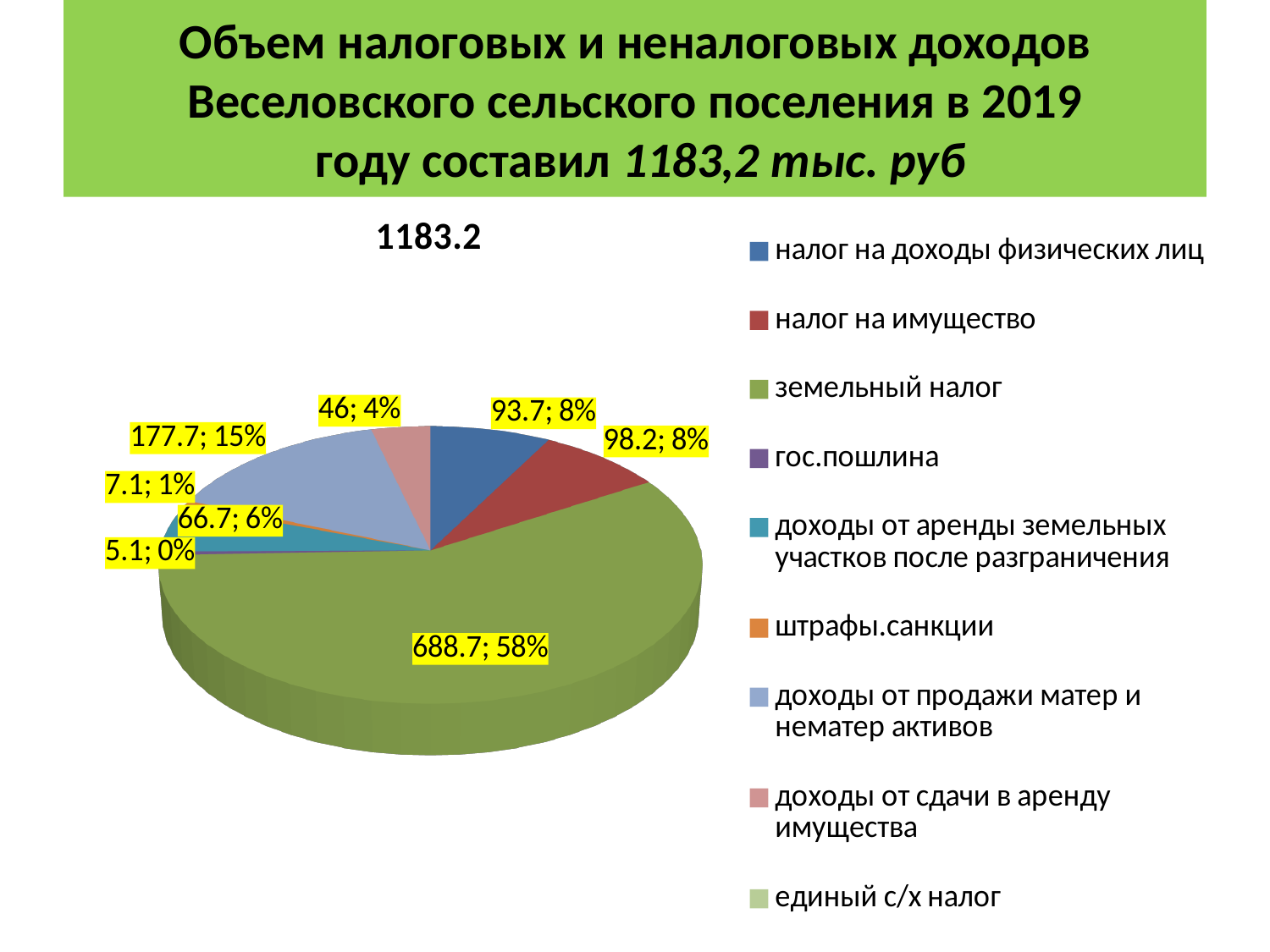
What is the title shown above the pie chart? 1183.2 What is the value for земельный налог? 688.7 What is the value for штрафы.санкции? 7.1 How many entries does the legend list? 9 What share of the pie does земельный налог take? 58% Which category has the largest slice of the pie? земельный налог What is the difference between доходы от продажи матер и нематер активов and доходы от сдачи в аренду имущества? 131.7 Which is larger: налог на имущество or налог на доходы физических лиц? налог на имущество What is the value for налог на имущество? 98.2 What is the value for доходы от продажи матер и нематер активов? 177.7 What kind of chart is shown on the slide? pie chart What share of the pie does доходы от сдачи в аренду имущества take? 4%